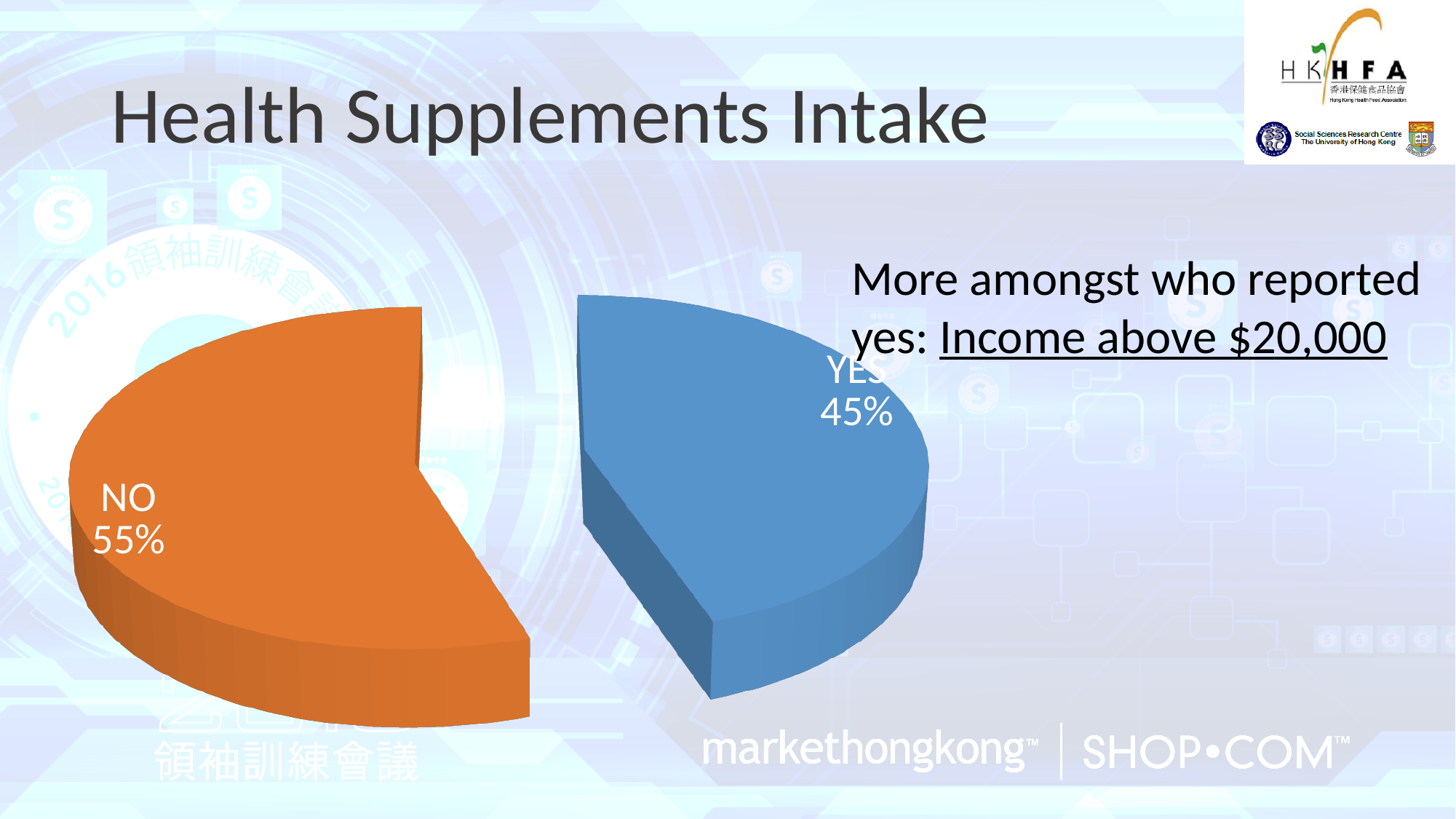
What kind of chart is shown on the slide? pie chart Which is larger, the YES slice or the NO slice? NO What share of the pie does the YES slice represent? 45% Which slice of the pie is the smallest? YES What colour is the YES slice of the pie? blue What is the difference in percentage points between the NO and YES slices? 10 Which slice of the pie is the largest? NO What percentage of respondents answered YES to health supplements intake? 45% What colour is the NO slice of the pie? orange What percentage of respondents answered NO to health supplements intake? 55% How many slices does the pie chart have? 2